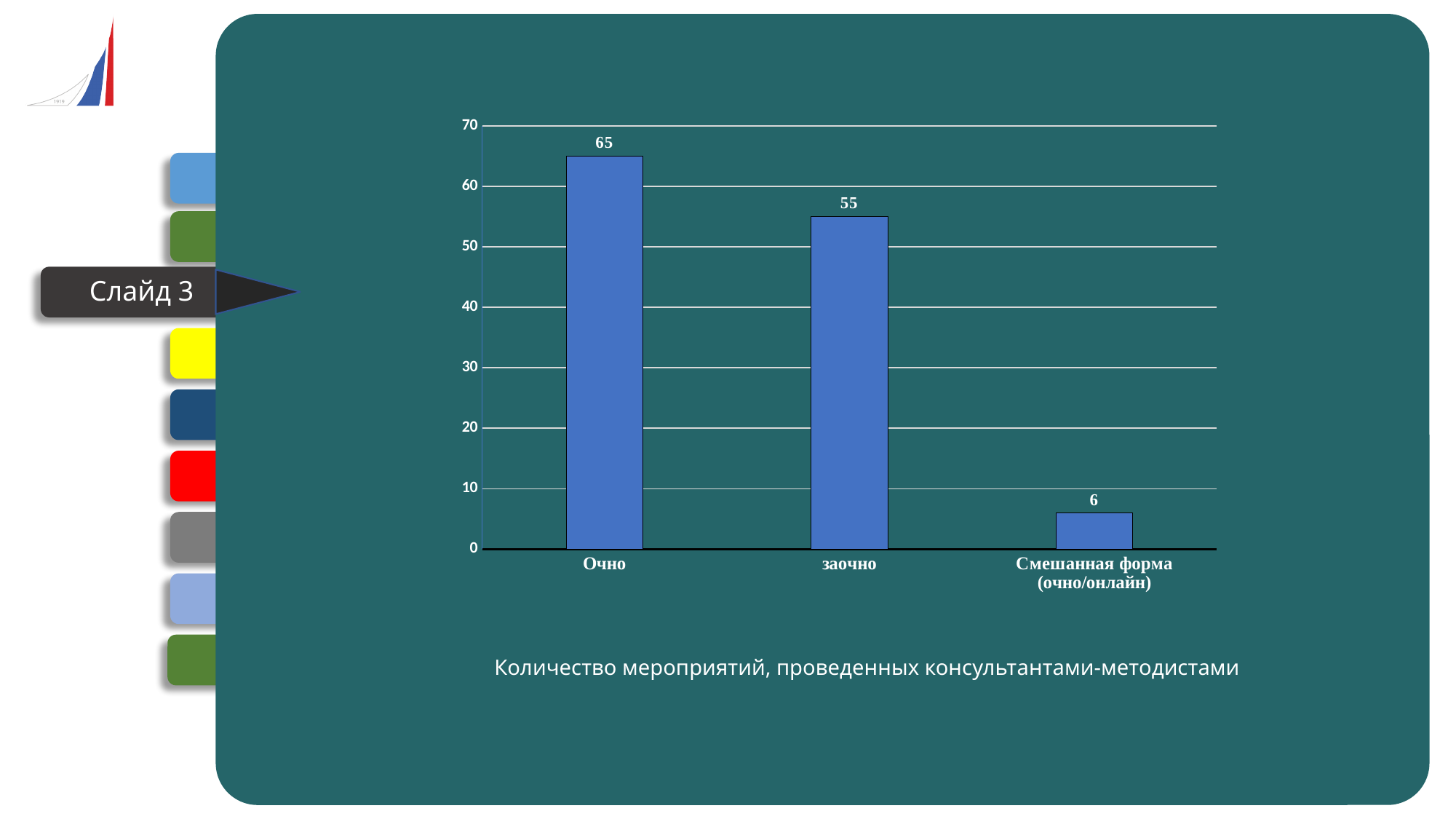
What is the difference between the values for Очно and заочно? 10 Which category has the highest value? Очно What is the caption shown below the chart? Количество мероприятий, проведенных консультантами-методистами What kind of chart is shown on the slide? bar chart Which category has the lowest value? Смешанная форма (очно/онлайн) What is the value for заочно? 55 Is the value for заочно greater or less than 50? greater What is the value for Очно? 65 Which is larger, the value for Очно or the value for заочно? Очно How many categories are shown on the chart? 3 What is the difference between the values for заочно and Смешанная форма (очно/онлайн)? 49 What is the value for Смешанная форма (очно/онлайн)? 6